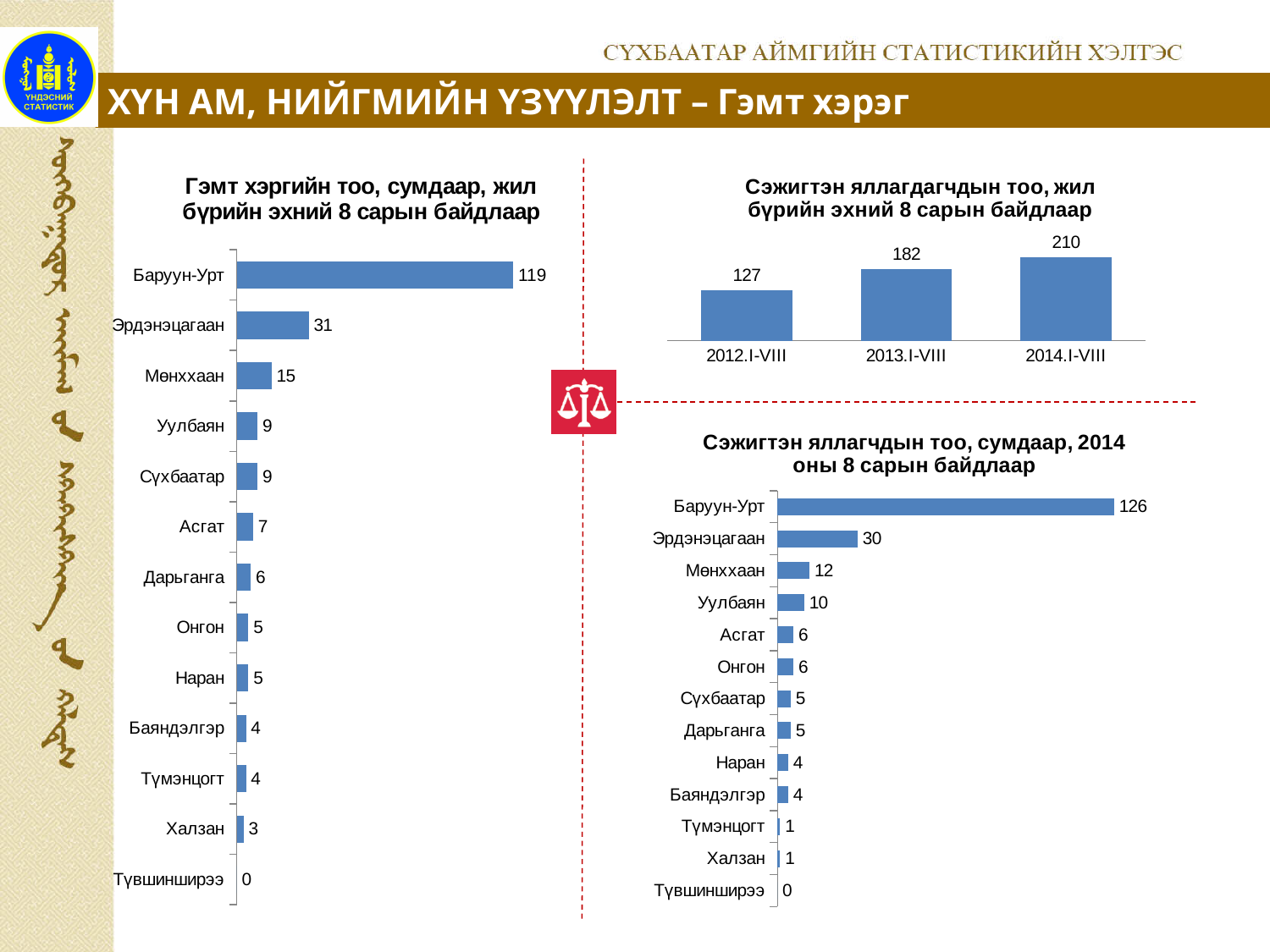
In the top-right chart 'Сэжигтэн яллагдагчдын тоо', do the values rise or fall from 2012.I-VIII to 2014.I-VIII? rise In the left chart 'Гэмт хэргийн тоо, сумдаар', what is the value for Мөнххаан? 15 In the bottom-right chart 'Сэжигтэн яллагчдын тоо, сумдаар, 2014 оны 8 сарын байдлаар', what is the value for Уулбаян? 10 In the top-right chart 'Сэжигтэн яллагдагчдын тоо', what is the difference between 2014.I-VIII and 2012.I-VIII? 83 In the bottom-right chart 'Сэжигтэн яллагчдын тоо, сумдаар, 2014', which category has the highest value? Баруун-Урт In the left chart 'Гэмт хэргийн тоо, сумдаар', how many categories are shown? 13 In the left chart 'Гэмт хэргийн тоо, сумдаар', what is the difference between Баруун-Урт and Эрдэнэцагаан? 88 In the left chart 'Гэмт хэргийн тоо, сумдаар, жил бүрийн эхний 8 сарын байдлаар', what is the value for Баруун-Урт? 119 In the bottom-right chart 'Сэжигтэн яллагчдын тоо, сумдаар, 2014', which is larger, Мөнххаан or Асгат? Мөнххаан What kind of chart is the top-right chart 'Сэжигтэн яллагдагчдын тоо, жил бүрийн эхний 8 сарын байдлаар'? bar chart In the left chart 'Гэмт хэргийн тоо, сумдаар', which category has the lowest value? Түвшинширээ In the top-right chart 'Сэжигтэн яллагдагчдын тоо, жил бүрийн эхний 8 сарын байдлаар', what is the value for 2013.I-VIII? 182